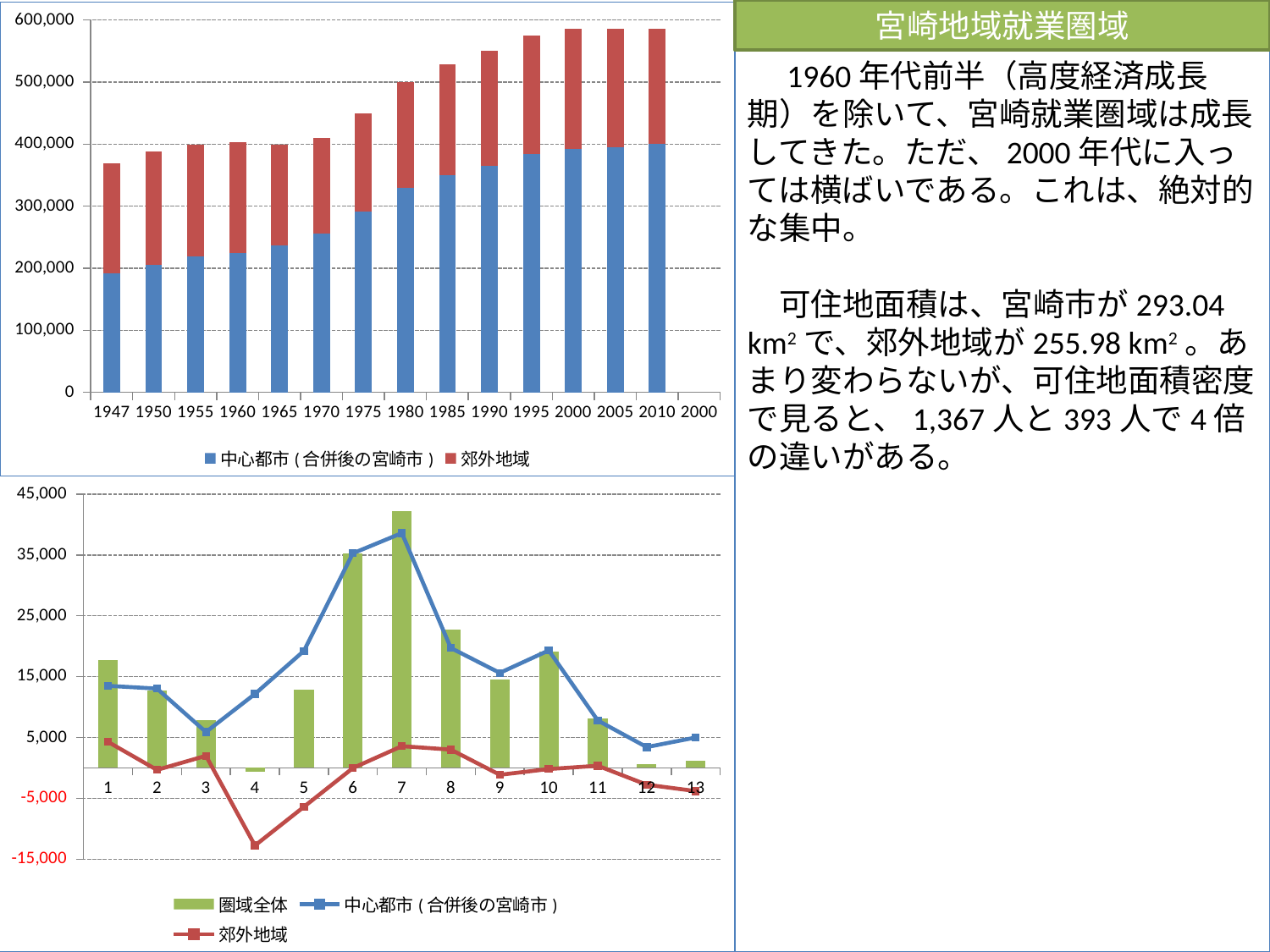
In the bottom chart, how many categories are on the x axis? 13 In the top chart, which year has the lowest total bar? 1947 In the top chart, is the total for 2010 greater or less than 500,000? greater In the top chart, how many series does the legend list? 2 In the bottom chart, at which category is the 圏域全体 bar highest? 7 In the top chart, do the total bars generally rise or fall from 1947 to 2010? rise In the top chart, is the 中心都市(合併後の宮崎市) value for 1975 greater or less than 250,000? greater What kind of chart is the top chart? Stacked bar chart In the bottom chart, at which category is the 郊外地域 line lowest? 4 In the bottom chart, how many series does the legend list? 3 In the top chart, is the total for 1947 greater or less than 400,000? less In the top chart, which total is larger, 1960 or 1980? 1980